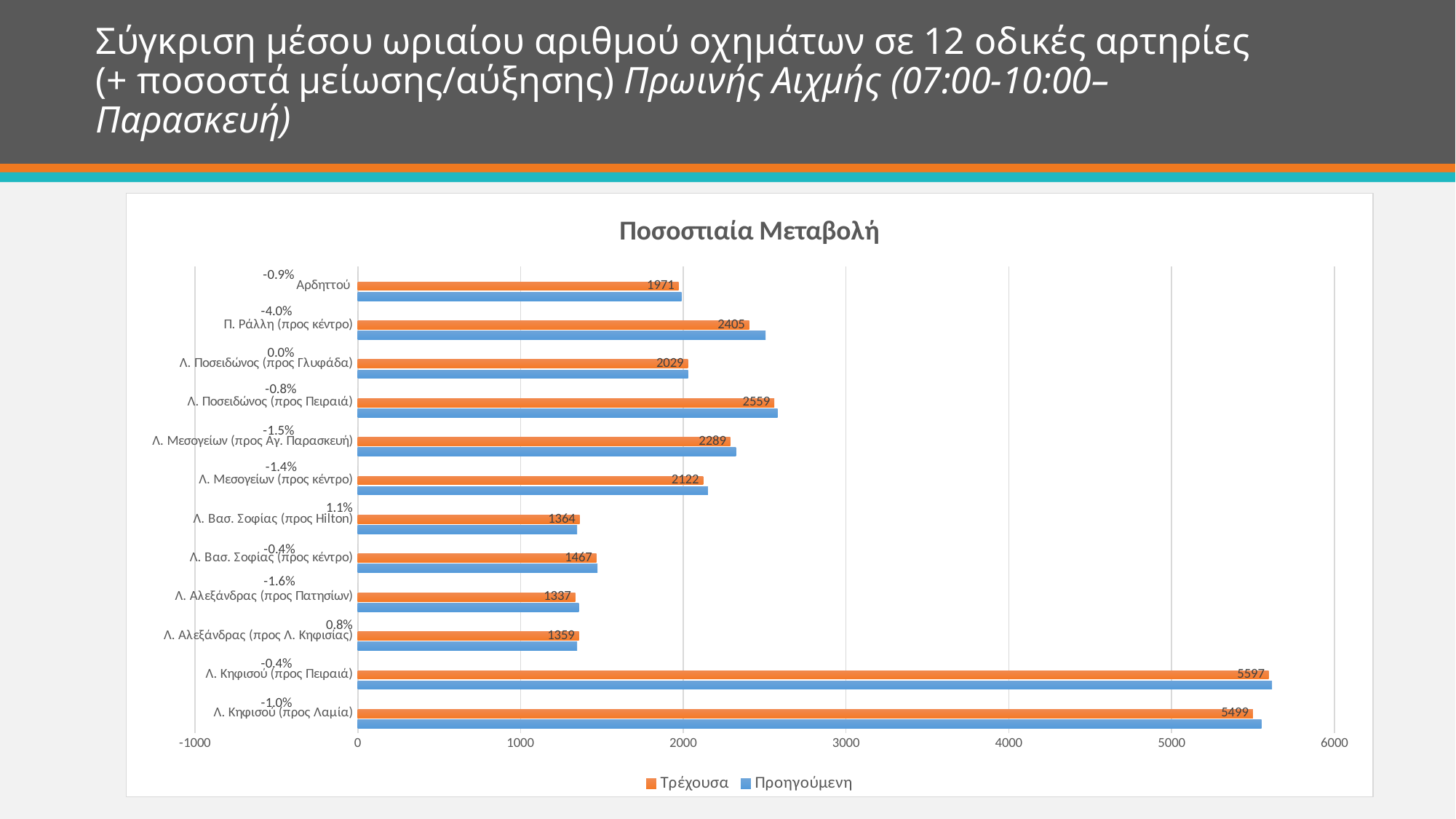
Which road has the highest Τρέχουσα value? Λ. Κηφισού (προς Πειραιά) What is the difference between the Τρέχουσα values for Λ. Κηφισού (προς Πειραιά) and Λ. Κηφισού (προς Λαμία)? 98 How many series does the legend list? 2 What is the Τρέχουσα value for Λ. Κηφισού (προς Πειραιά)? 5597 How many roads are shown in the chart? 12 Is the Προηγούμενη value for Λ. Κηφισού (προς Πειραιά) greater or less than 5000? greater Which road has the lowest Τρέχουσα value? Λ. Αλεξάνδρας (προς Πατησίων) Which is larger, the Τρέχουσα value for Π. Ράλλη (προς κέντρο) or for Λ. Μεσογείων (προς κέντρο)? Π. Ράλλη (προς κέντρο) Is the Προηγούμενη value for Αρδηττού greater or less than 3000? less What is the Τρέχουσα value for Λ. Ποσειδώνος (προς Πειραιά)? 2559 What is the Τρέχουσα value for Λ. Βασ. Σοφίας (προς Hilton)? 1364 What type of chart is shown on the slide? bar chart